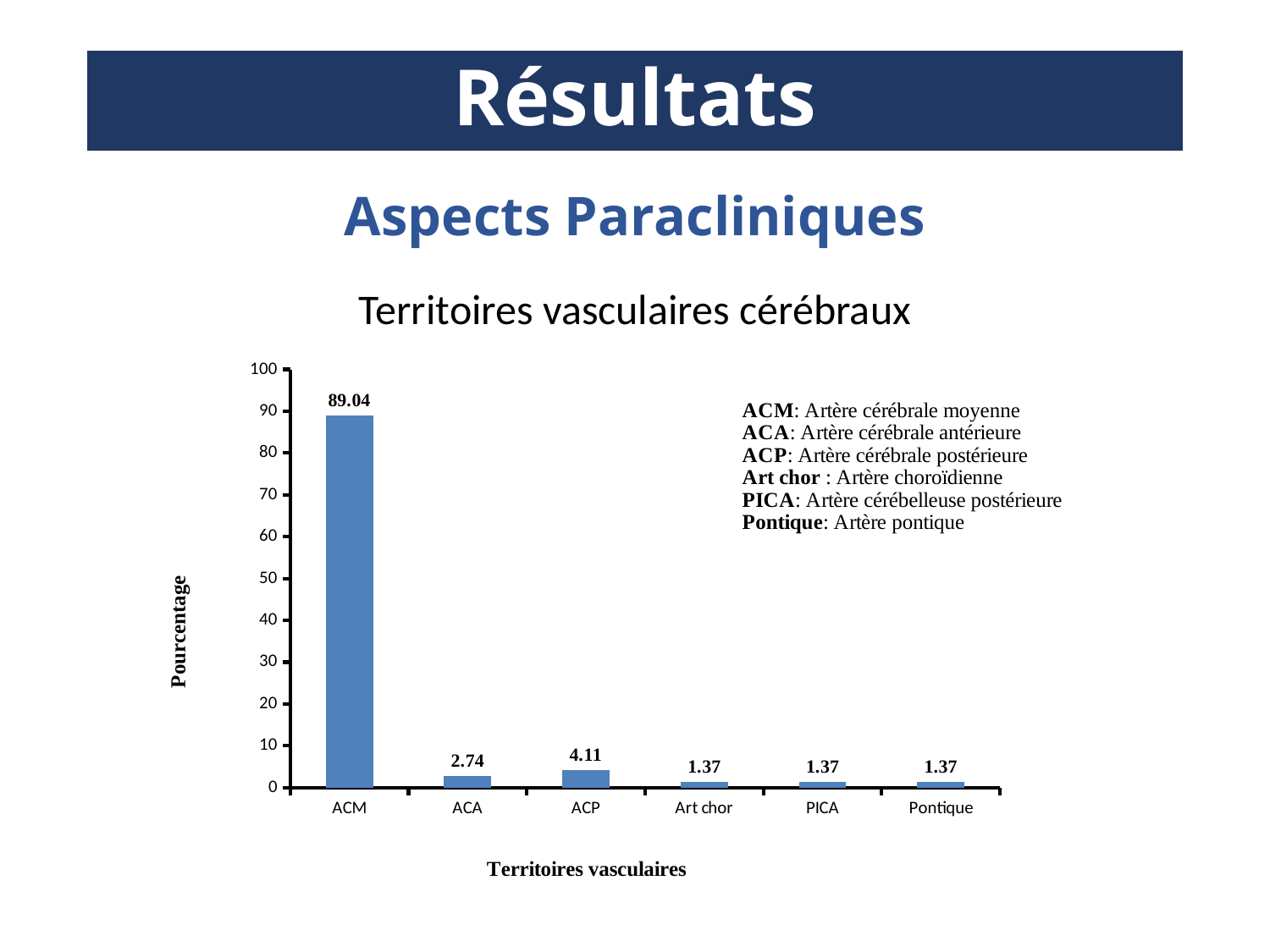
What is the difference between the values for ACM and ACP? 84.93 What is the value for PICA? 1.37 What is the value for ACP? 4.11 How many vascular territories are shown on the x axis? 6 What is the value for ACM? 89.04 What is the difference between the values for ACP and ACA? 1.37 Is the value for ACM greater or less than 80? greater Which territory has the highest value? ACM Which is larger, the value for ACA or the value for ACP? ACP What kind of chart is shown on the slide? bar chart What is the value for ACA? 2.74 What is the label of the y axis? Pourcentage